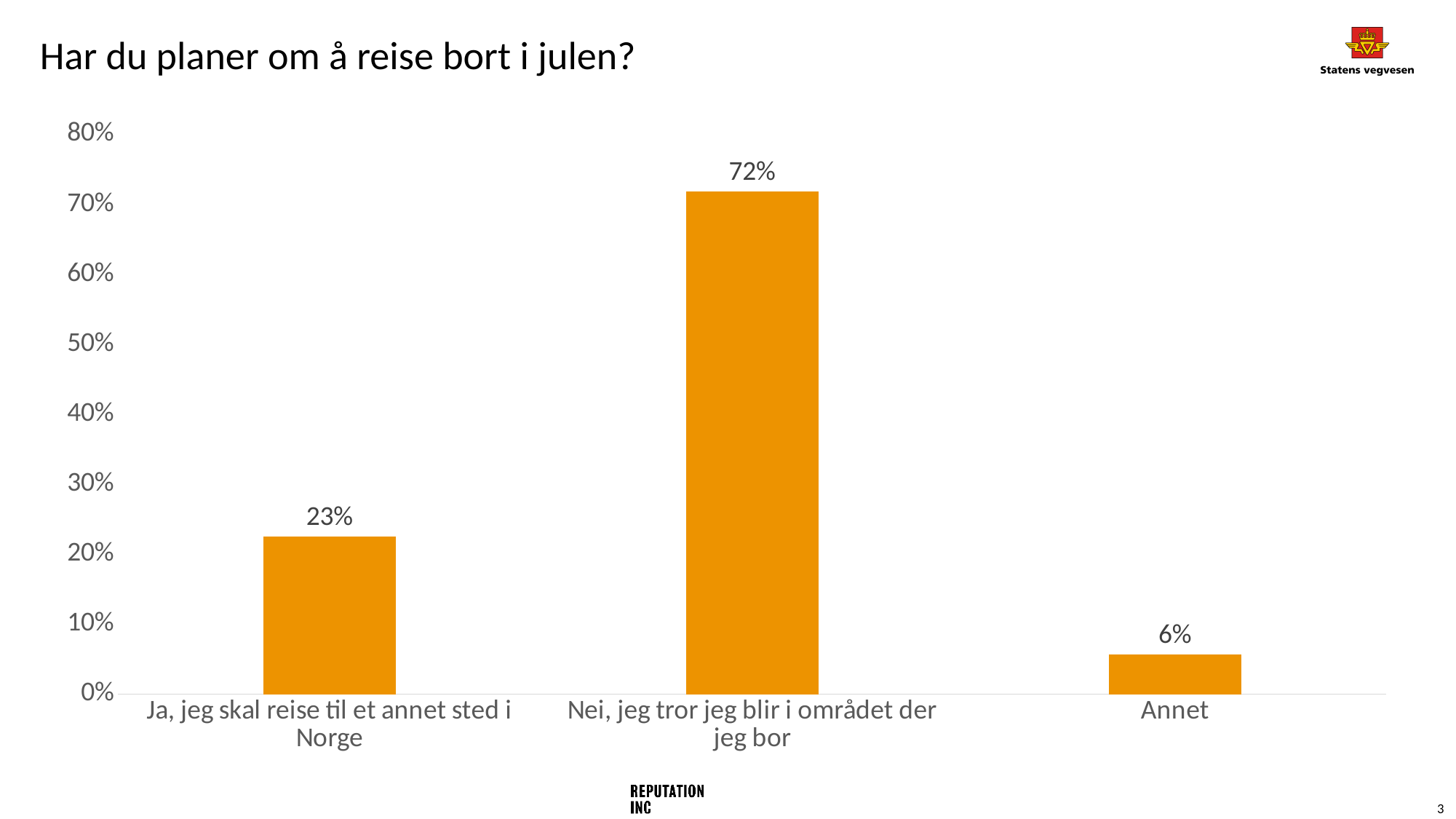
Which answer category has the lowest value? Annet What percentage of respondents answered "Annet"? 6% What is the title of the slide? Har du planer om å reise bort i julen? What percentage of respondents answered "Nei, jeg tror jeg blir i området der jeg bor"? 72% Which answer category has the highest value? Nei, jeg tror jeg blir i området der jeg bor What is the difference in percentage points between "Nei, jeg tror jeg blir i området der jeg bor" and "Ja, jeg skal reise til et annet sted i Norge"? 49 percentage points Is the value for "Nei, jeg tror jeg blir i området der jeg bor" greater or less than 50%? greater Which is larger: the value for "Ja, jeg skal reise til et annet sted i Norge" or the value for "Annet"? Ja, jeg skal reise til et annet sted i Norge What is the difference in percentage points between "Ja, jeg skal reise til et annet sted i Norge" and "Annet"? 17 percentage points How many answer categories are shown in the chart? 3 What percentage of respondents answered "Ja, jeg skal reise til et annet sted i Norge"? 23% What kind of chart is shown on the slide? Bar chart